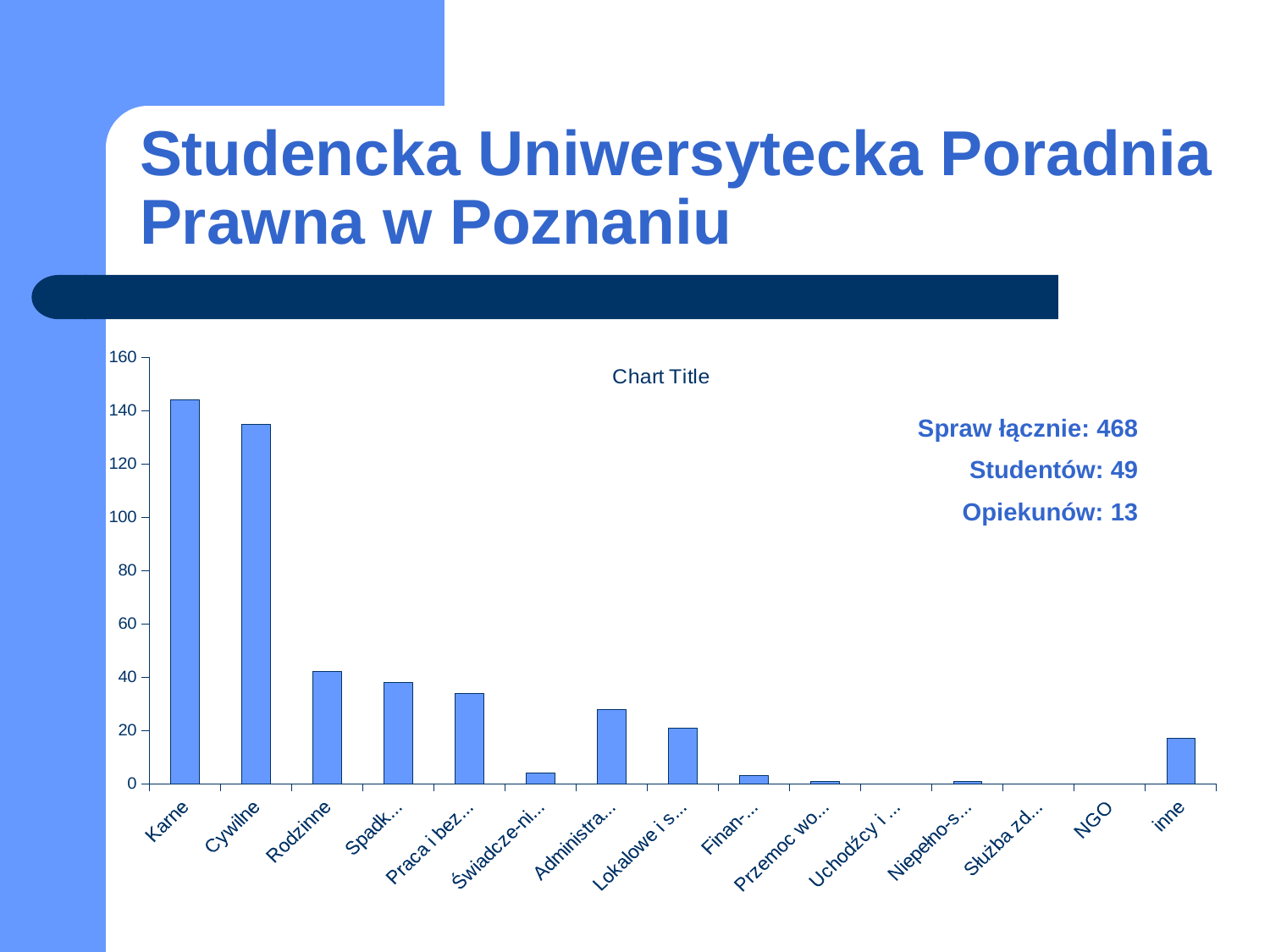
Is the value for Rodzinne greater or less than 60? less Which is larger, the value for Rodzinne or the value for inne? Rodzinne Which category has the highest value in the chart? Karne How many categories are shown along the x axis of the chart? 15 Is the value for inne greater or less than 20? less Which is larger, the value for Karne or the value for Cywilne? Karne Is the value for Rodzinne greater or less than 20? greater What is the title shown on the chart? Chart Title What kind of chart is shown on the slide? bar chart What is the highest value shown on the chart's vertical axis? 160